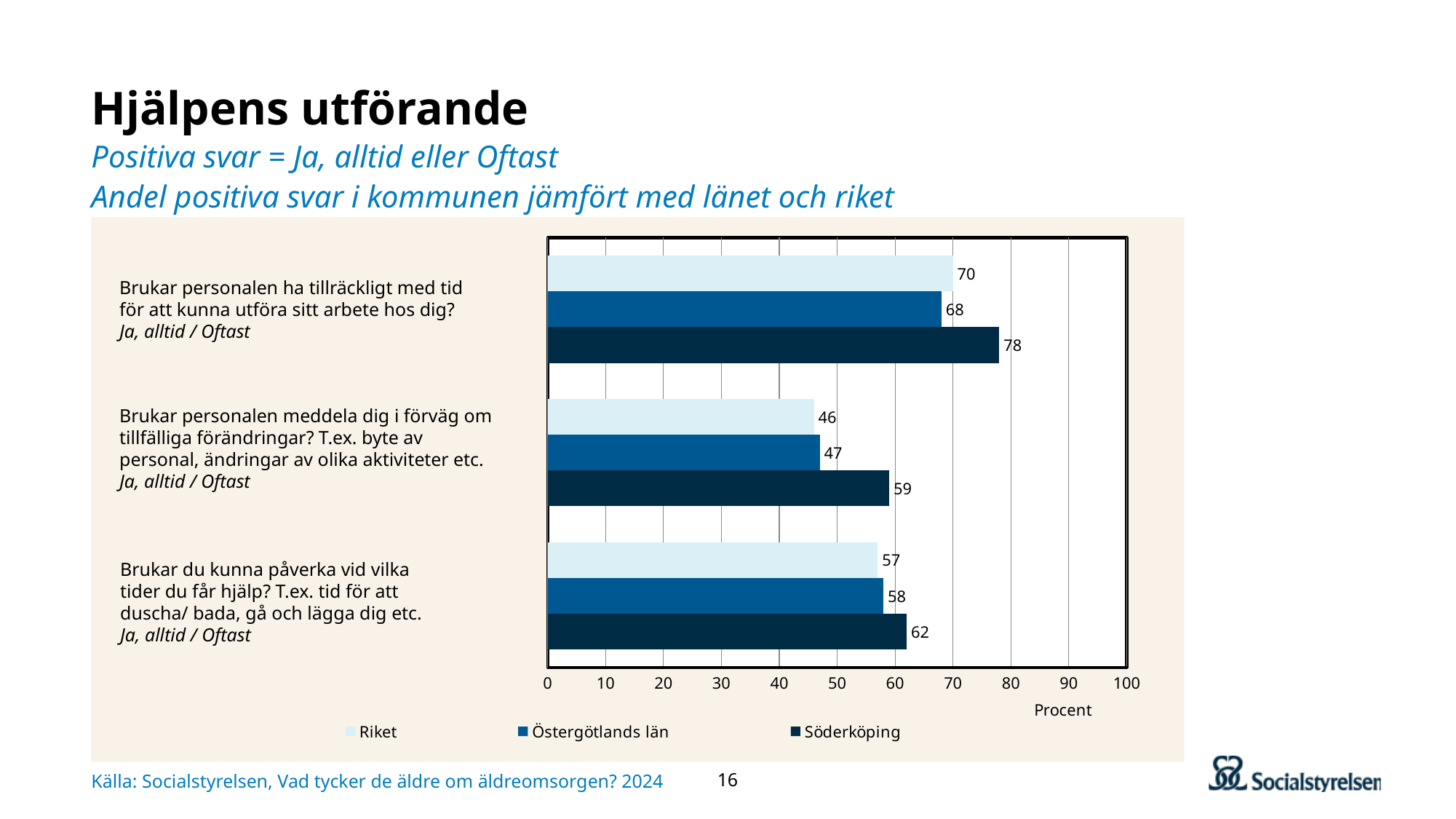
Which series has the highest value on the question "Brukar personalen meddela dig i förväg om tillfälliga förändringar?"? Söderköping Which is larger on the question "Brukar personalen ha tillräckligt med tid för att kunna utföra sitt arbete hos dig?": Riket or Söderköping? Söderköping How many series does the legend list? 3 Is the value for Söderköping on the question "Brukar du kunna påverka vid vilka tider du får hjälp?" greater or less than 60? greater What is the difference between Söderköping and Riket on the question "Brukar personalen meddela dig i förväg om tillfälliga förändringar?"? 13 How many questions (categories) are shown on the chart? 3 What unit is shown on the x axis of the chart? Procent What kind of chart is shown on the slide? Bar chart What is the value for Östergötlands län on the question "Brukar du kunna påverka vid vilka tider du får hjälp?"? 58 What is the value for Riket on the question "Brukar personalen meddela dig i förväg om tillfälliga förändringar?"? 46 What is the value for Söderköping on the question "Brukar personalen ha tillräckligt med tid för att kunna utföra sitt arbete hos dig?"? 78 Which series has the lowest value on the question "Brukar personalen ha tillräckligt med tid för att kunna utföra sitt arbete hos dig?"? Östergötlands län